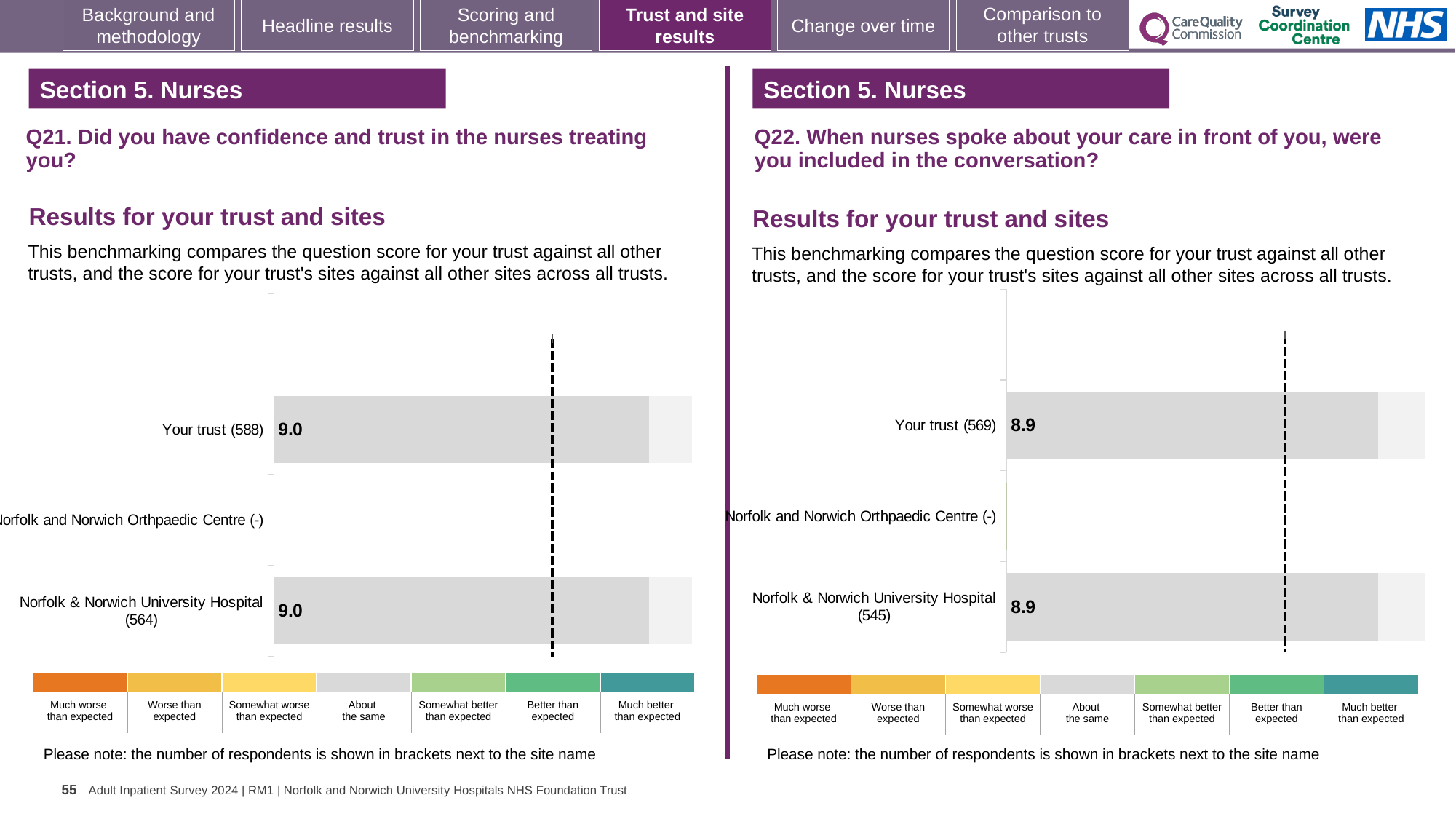
On the Q21 chart (left), how many categories are listed on the vertical axis? 3 On the Q22 chart (right), how many respondents are shown in brackets for Your trust? 569 On the Q21 chart (left), what is the difference between the score for Your trust (588) and the score for Norfolk & Norwich University Hospital (564)? 0.0 On the Q21 chart (left), what is the score for Norfolk & Norwich University Hospital (564)? 9.0 On the Q22 chart (right), what is the difference between the score for Your trust (569) and the score for Norfolk & Norwich University Hospital (545)? 0.0 On the Q21 chart (left), which category has no bar plotted? Norfolk and Norwich Orthpaedic Centre (-) What kind of chart is the Q21 chart on the left? Bar chart On the Q22 chart (right), what is the score for Your trust (569)? 8.9 On the Q21 chart (left), what is the score for Your trust (588)? 9.0 On the Q22 chart (right), what is the score for Norfolk & Norwich University Hospital (545)? 8.9 On the Q22 chart (right), how many categories are listed on the vertical axis? 3